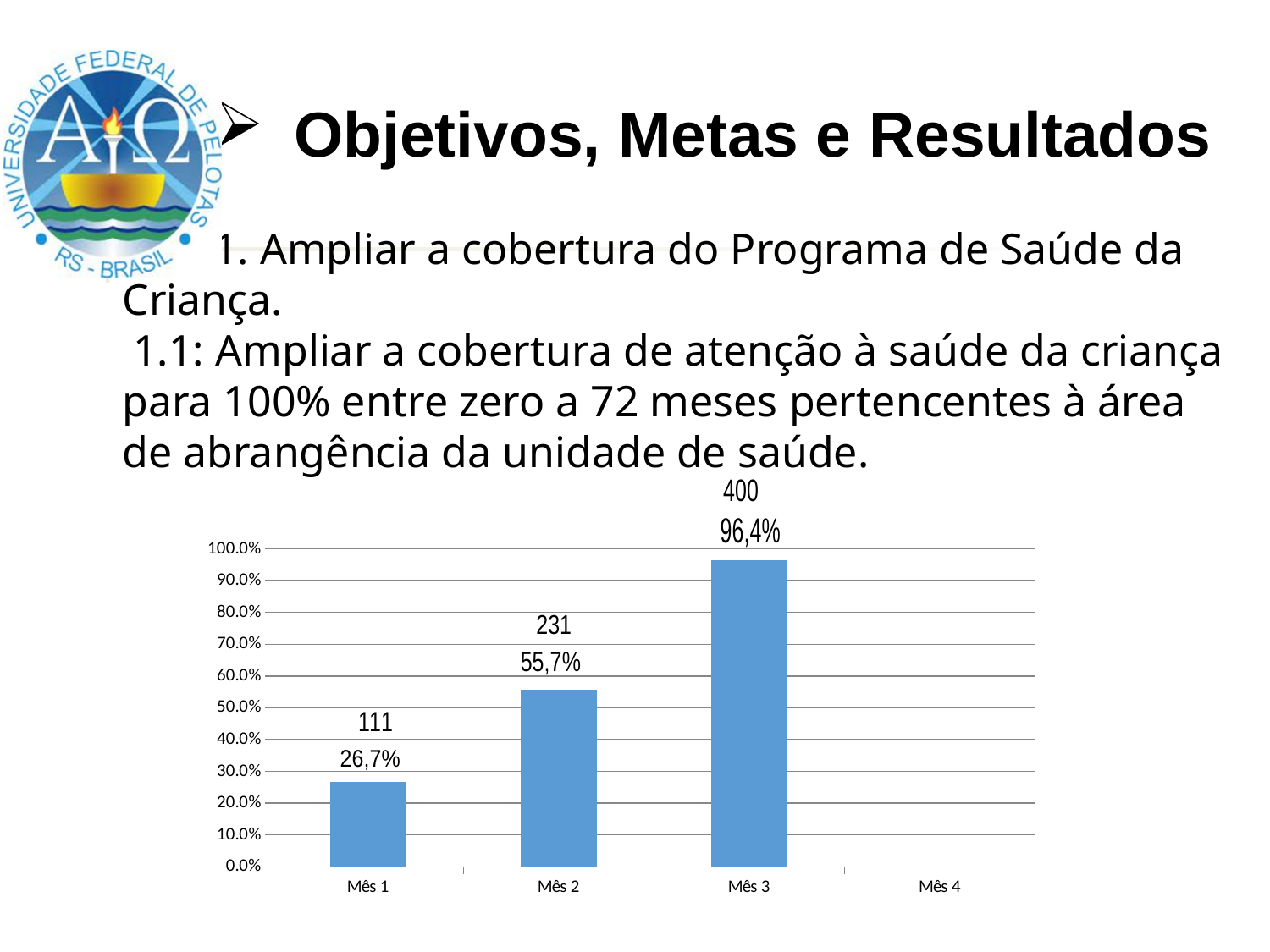
Is the value for Mês 2 greater or less than 50.0%? greater What percentage is shown for Mês 3? 96,4% What percentage is shown for Mês 2? 55,7% Which month has the highest bar? Mês 3 What is the difference in percentage between Mês 3 and Mês 1? 69,6% Do the values rise or fall from Mês 1 to Mês 3? rise What is the difference between the counts printed for Mês 2 and Mês 1? 120 What percentage is shown for Mês 1? 26,7% Among the months with a bar, which has the lowest value? Mês 1 What count is printed above the bar for Mês 3? 400 Which is larger, the value for Mês 2 or the value for Mês 1? Mês 2 How many month categories are labelled on the x axis? 4